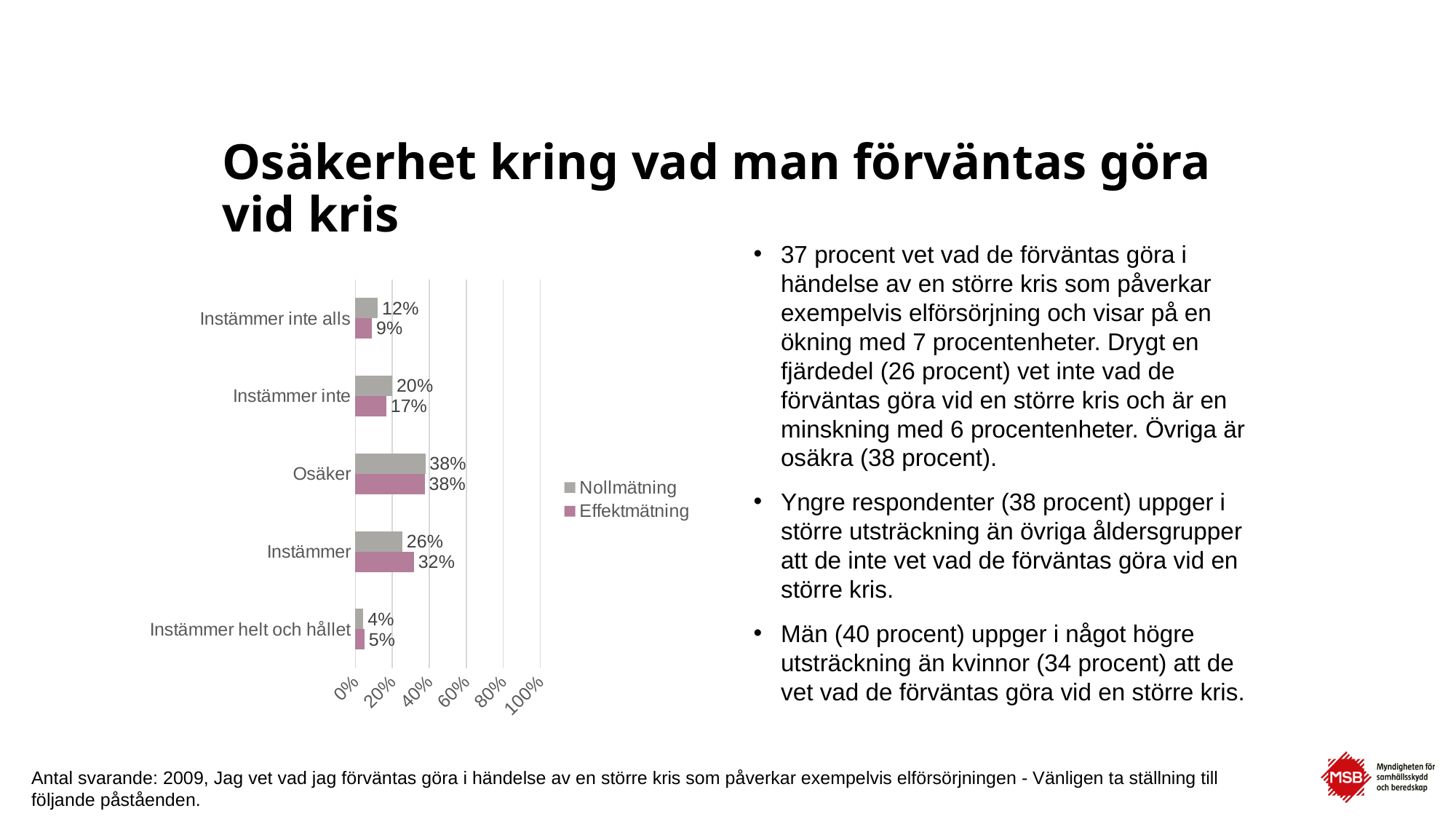
How many categories are shown on the chart? 5 How many series does the legend list? 2 What is the Effektmätning value for Instämmer? 32% Which is larger for Instämmer inte: the Nollmätning value or the Effektmätning value? Nollmätning Which series is shown in pink/purple in the legend? Effektmätning Which category has the lowest Nollmätning value? Instämmer helt och hållet Which category has the highest Effektmätning value? Osäker What is the Nollmätning value for Osäker? 38% What is the Effektmätning value for Instämmer helt och hållet? 5% What kind of chart is shown on the slide? Bar chart What is the Nollmätning value for Instämmer inte alls? 12% What is the difference between the Nollmätning and Effektmätning values for Instämmer? 6%